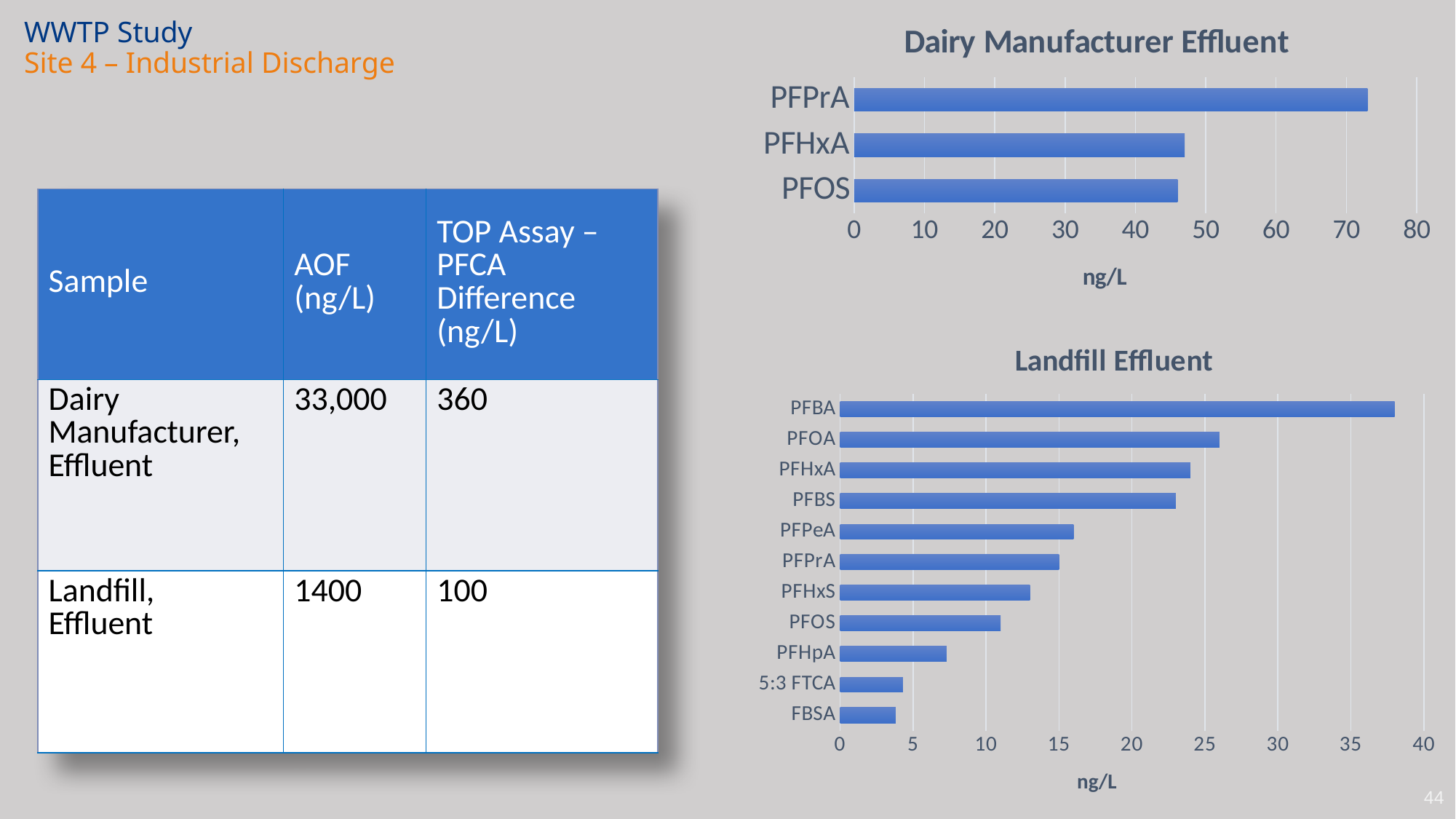
How many compounds are plotted in the Landfill Effluent chart? 11 In the Dairy Manufacturer Effluent chart, is the value for PFHxA greater or less than 50? less How many compounds are plotted in the Dairy Manufacturer Effluent chart? 3 In the Landfill Effluent chart, which compound has the lowest value? FBSA What kind of chart is the Dairy Manufacturer Effluent chart? bar chart In the Landfill Effluent chart, is the value for PFBA greater or less than 35? greater In the Dairy Manufacturer Effluent chart, which compound has the highest value? PFPrA In the Landfill Effluent chart, is the value for PFOS greater or less than 15? less In the Landfill Effluent chart, which is larger, the value for PFOA or the value for PFHpA? PFOA In the Landfill Effluent chart, which compound has the highest value? PFBA What unit is shown on the x axis of the Landfill Effluent chart? ng/L